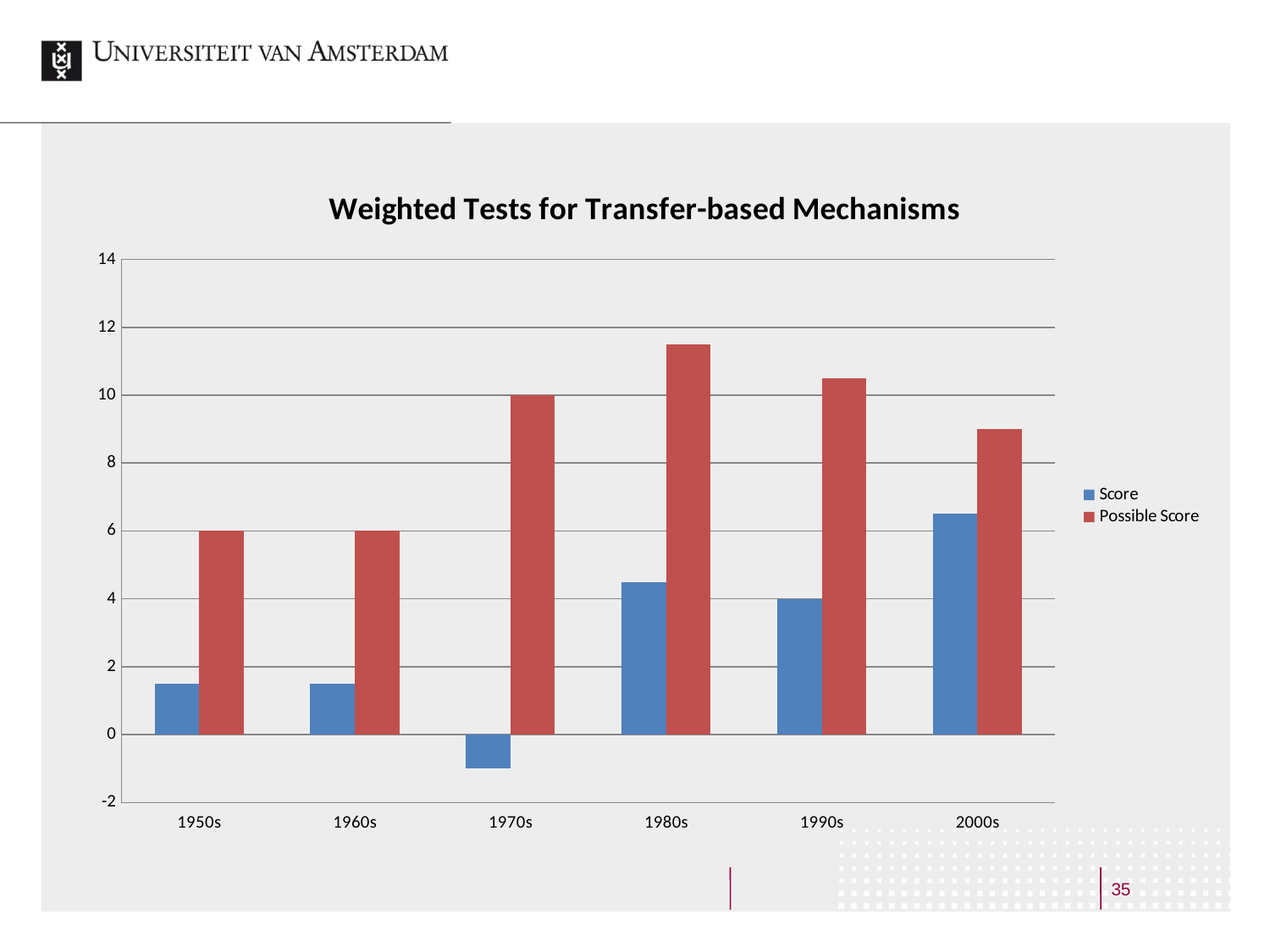
What is the Possible Score for the 1970s? 10 What is the difference between the Possible Score for the 1970s and the Possible Score for the 1950s? 4 How many decade categories are shown on the x axis? 6 How many series does the legend list? 2 Which decade has the highest Possible Score? 1980s Is the Score for the 1970s greater or less than 0? less Is the Score for the 2000s greater or less than 6? greater What is the Score for the 1990s? 4 What type of chart is shown on the slide? Bar chart What is the title of the chart? Weighted Tests for Transfer-based Mechanisms What is the Possible Score for the 1950s? 6 Which decade has the lowest Score? 1970s